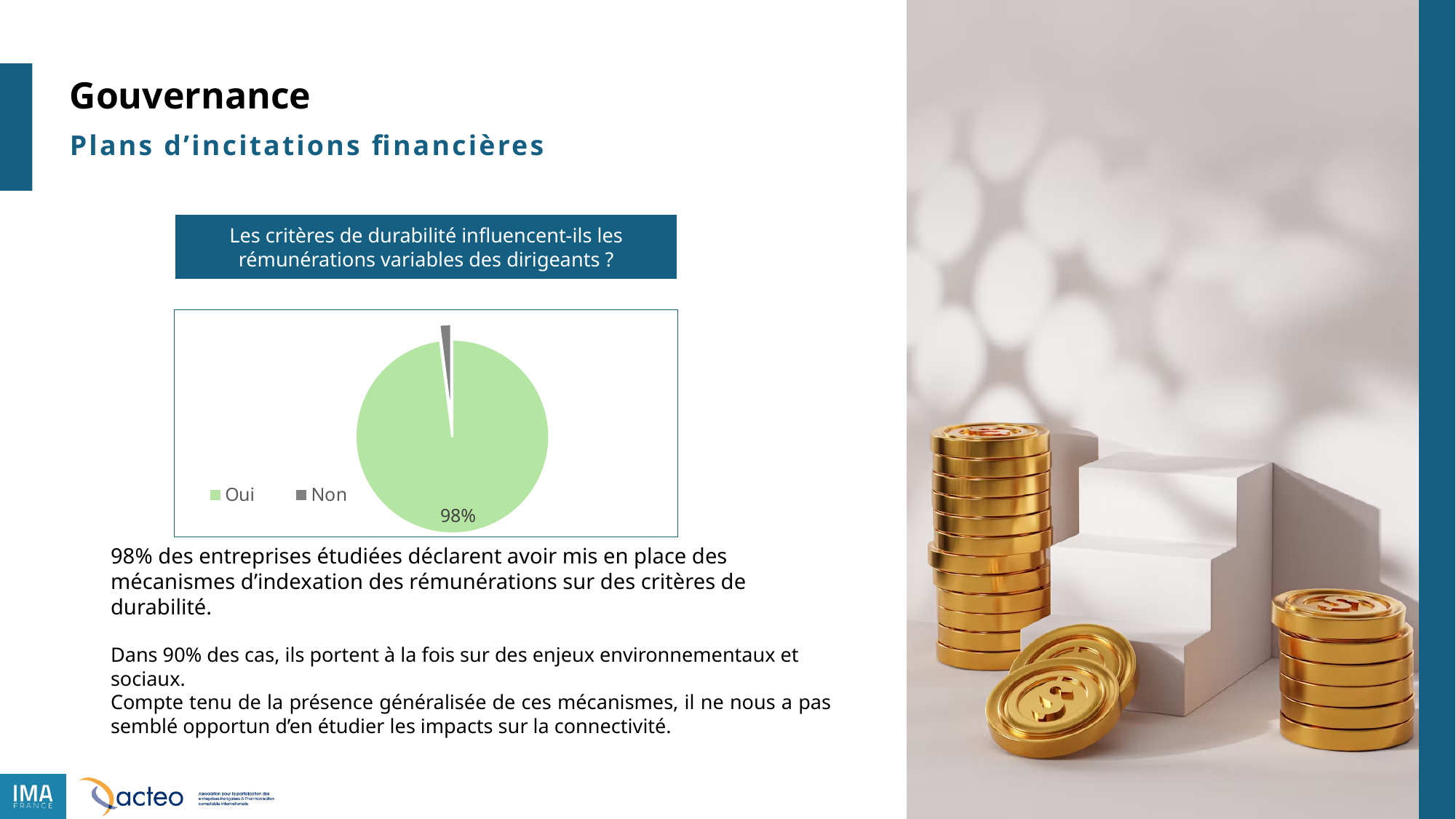
Which category has the smallest slice in the pie chart? Non What percentage is shown for "Oui" in the pie chart? 98% What question is posed in the blue box above the pie chart? Les critères de durabilité influencent-ils les rémunérations variables des dirigeants ? What kind of chart is shown on the slide? pie chart Which category has the largest slice in the pie chart? Oui How many categories does the legend of the pie chart list? 2 What share of the pie does the "Oui" slice represent? 98% How many slices does the pie chart have? 2 What colour is the "Oui" slice in the pie chart? green Which slice is larger in the pie chart, "Oui" or "Non"? Oui